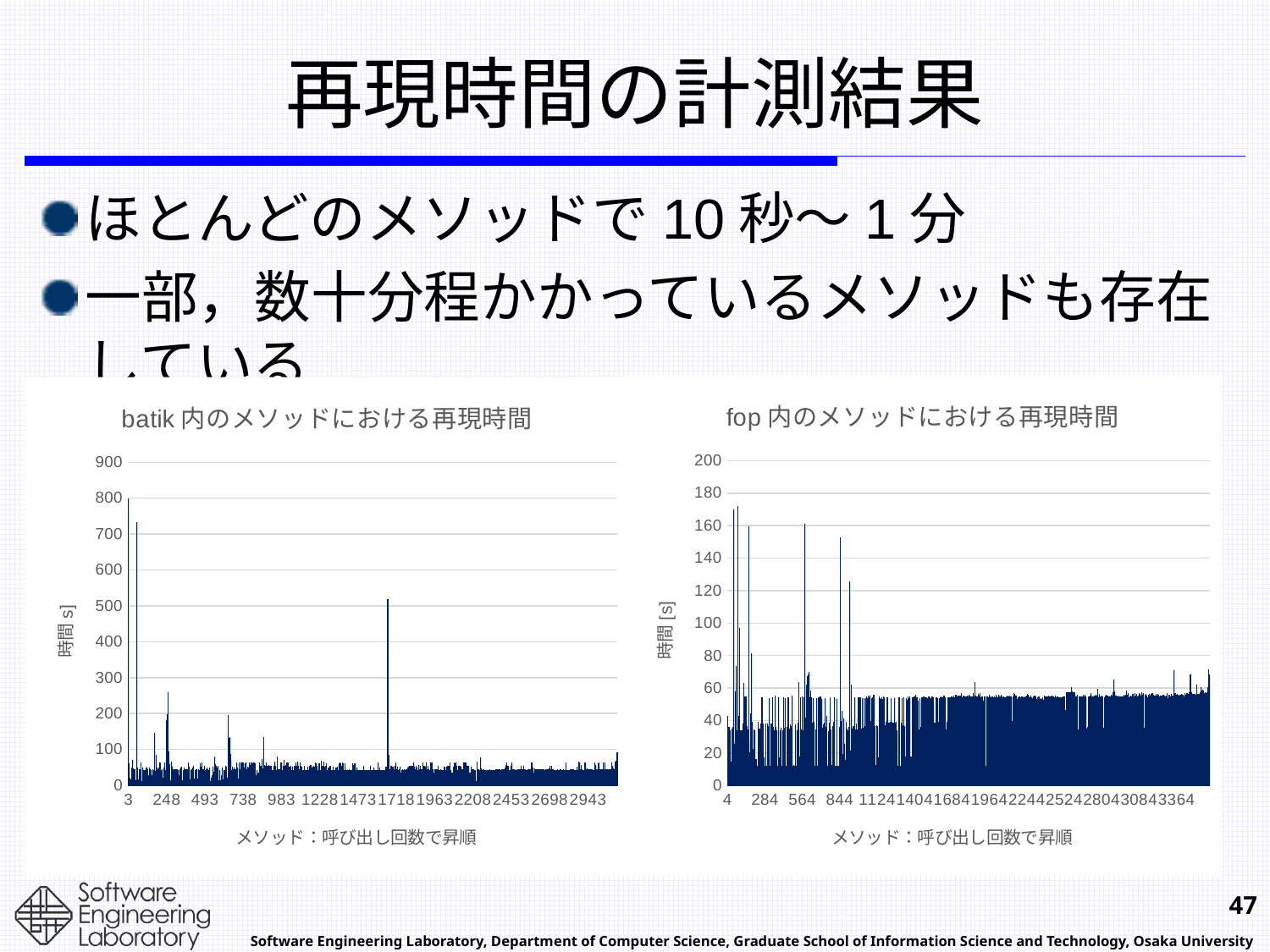
In the left chart (batik), is the tallest bar greater or less than 700? greater In the right chart (fop), is the tallest bar greater or less than 200? less What is the highest tick value on the y axis of the left chart (batik)? 900 What is the y-axis label of the right chart (fop)? 時間 [s] In the left chart (batik), is the bar at the far right of the x axis greater or less than 200? less What kind of chart is the right chart titled 'fop 内のメソッドにおける再現時間'? bar chart What kind of chart is the left chart titled 'batik 内のメソッドにおける再現時間'? bar chart